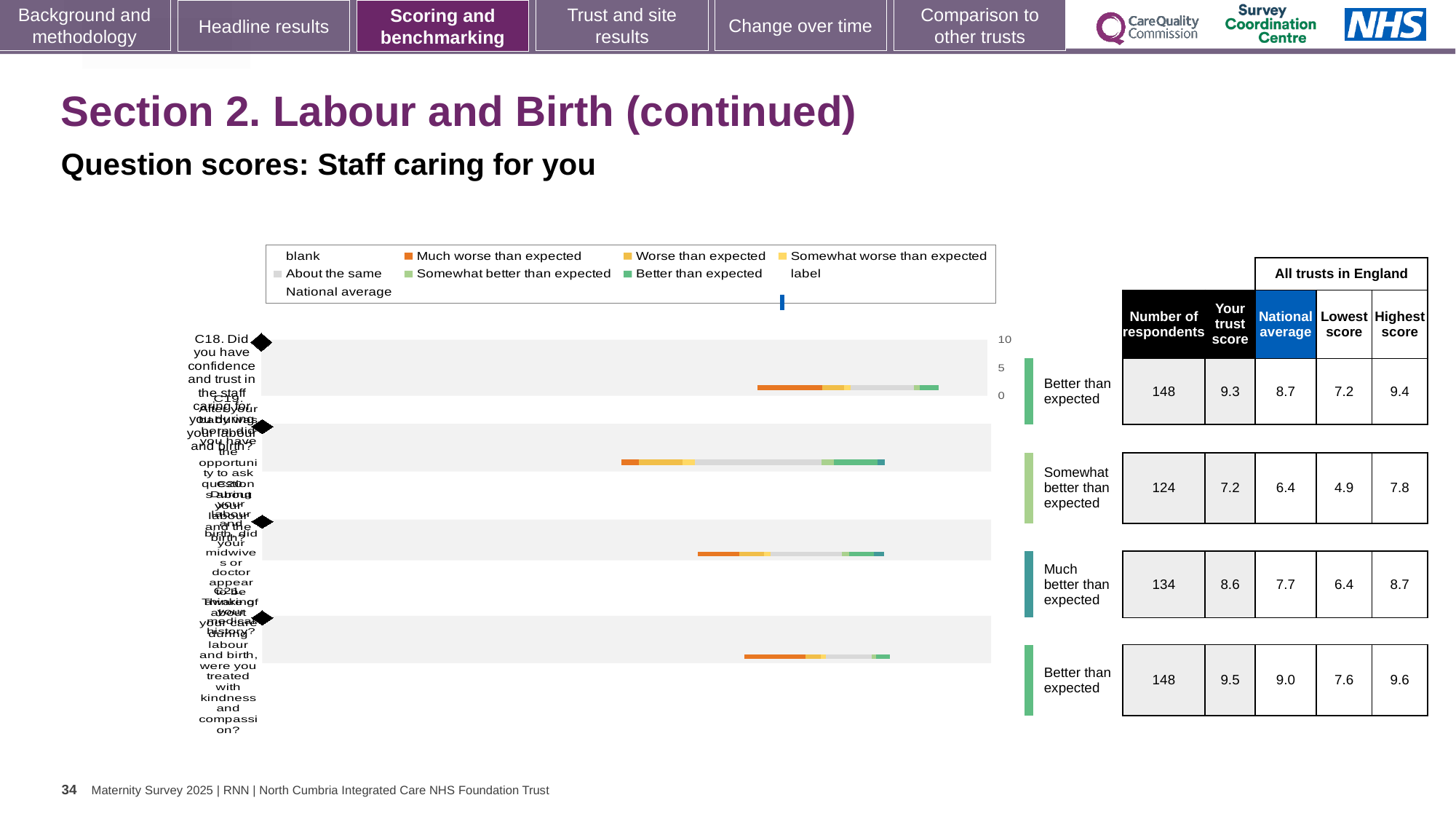
What is the 'Your trust score' value for the first question (C18) in the table? 9.3 For the third question row, is the trust score or the national average larger? Trust score (8.6) Which question row has the highest 'Your trust score' in the table? The fourth row (9.5) Which question row has the lowest 'Your trust score' in the table? The second row (7.2) What is the national average for the second question row in the table? 6.4 How many respondents are listed for the third question row? 134 For the first question (C18), what is the difference between the trust score and the national average? 0.6 How many question bars are plotted in the chart? 4 How many entries does the chart legend list? 9 What is the subtitle above the chart? Question scores: Staff caring for you What colour represents 'Much worse than expected' in the legend? Orange What kind of chart is shown on the slide? Bar chart